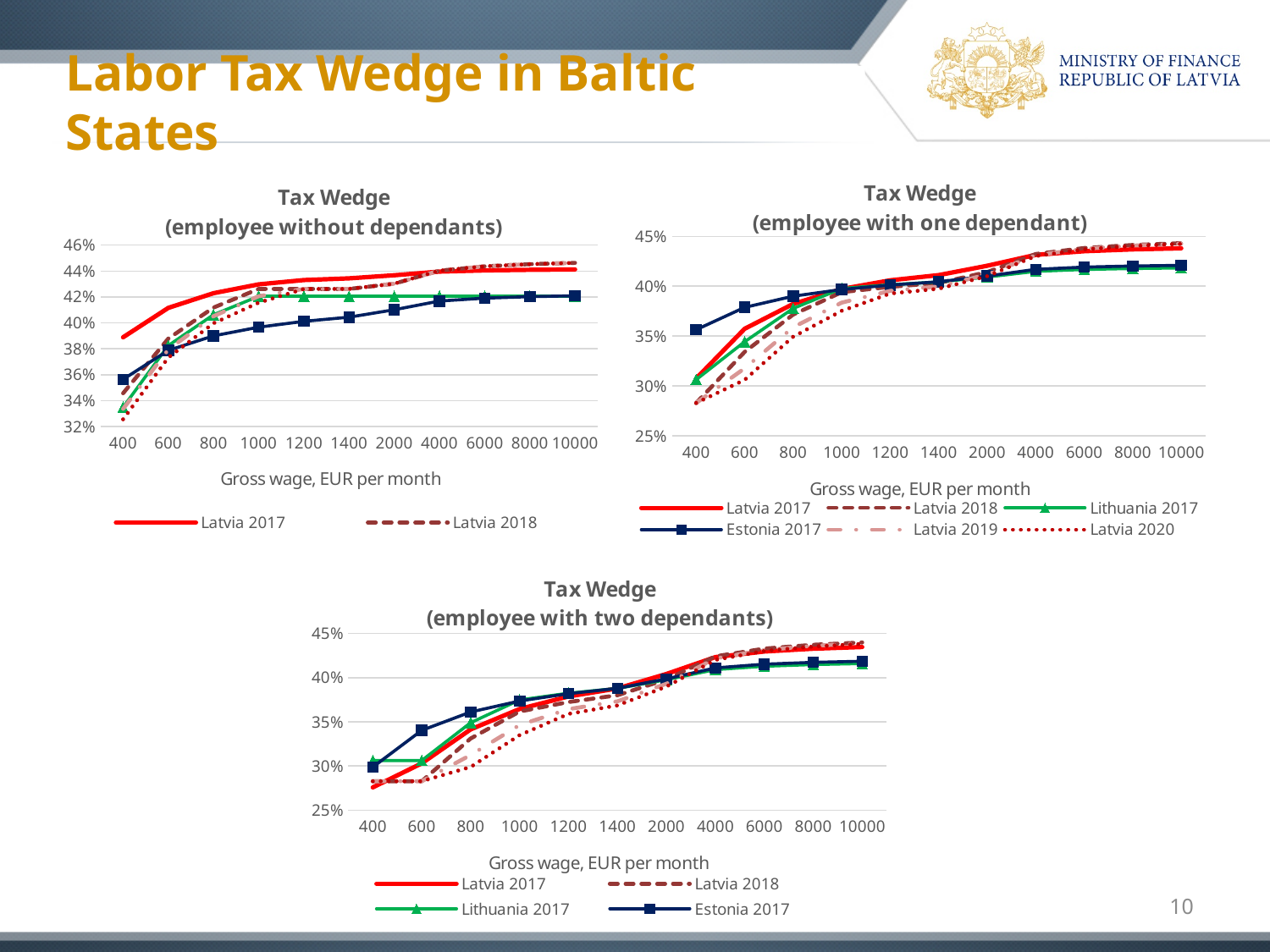
What kind of chart is the 'Tax Wedge (employee without dependants)' chart? line chart In the 'Tax Wedge (employee with one dependant)' chart, is the value for Estonia 2017 at a gross wage of 400 greater or less than 40%? less What is the x-axis title of the 'Tax Wedge (employee with two dependants)' chart? Gross wage, EUR per month In the 'Tax Wedge (employee with two dependants)' chart, is the value for Latvia 2017 at a gross wage of 400 greater or less than 30%? less In the 'Tax Wedge (employee with one dependant)' chart, which is higher at a gross wage of 400: Estonia 2017 or Latvia 2017? Estonia 2017 In the 'Tax Wedge (employee without dependants)' chart, which is higher at a gross wage of 400: Latvia 2017 or Estonia 2017? Latvia 2017 How many series does the legend of the 'Tax Wedge (employee with two dependants)' chart list? 4 How many series does the legend of the 'Tax Wedge (employee with one dependant)' chart list? 6 In the 'Tax Wedge (employee with one dependant)' chart, what colour is the Latvia 2017 line? red In the 'Tax Wedge (employee without dependants)' chart, does the Latvia 2017 line rise or fall as gross wage increases? rise How many gross wage levels are shown on the x axis of the 'Tax Wedge (employee without dependants)' chart? 11 In the 'Tax Wedge (employee without dependants)' chart, is the value for Latvia 2017 at a gross wage of 400 greater or less than 36%? greater